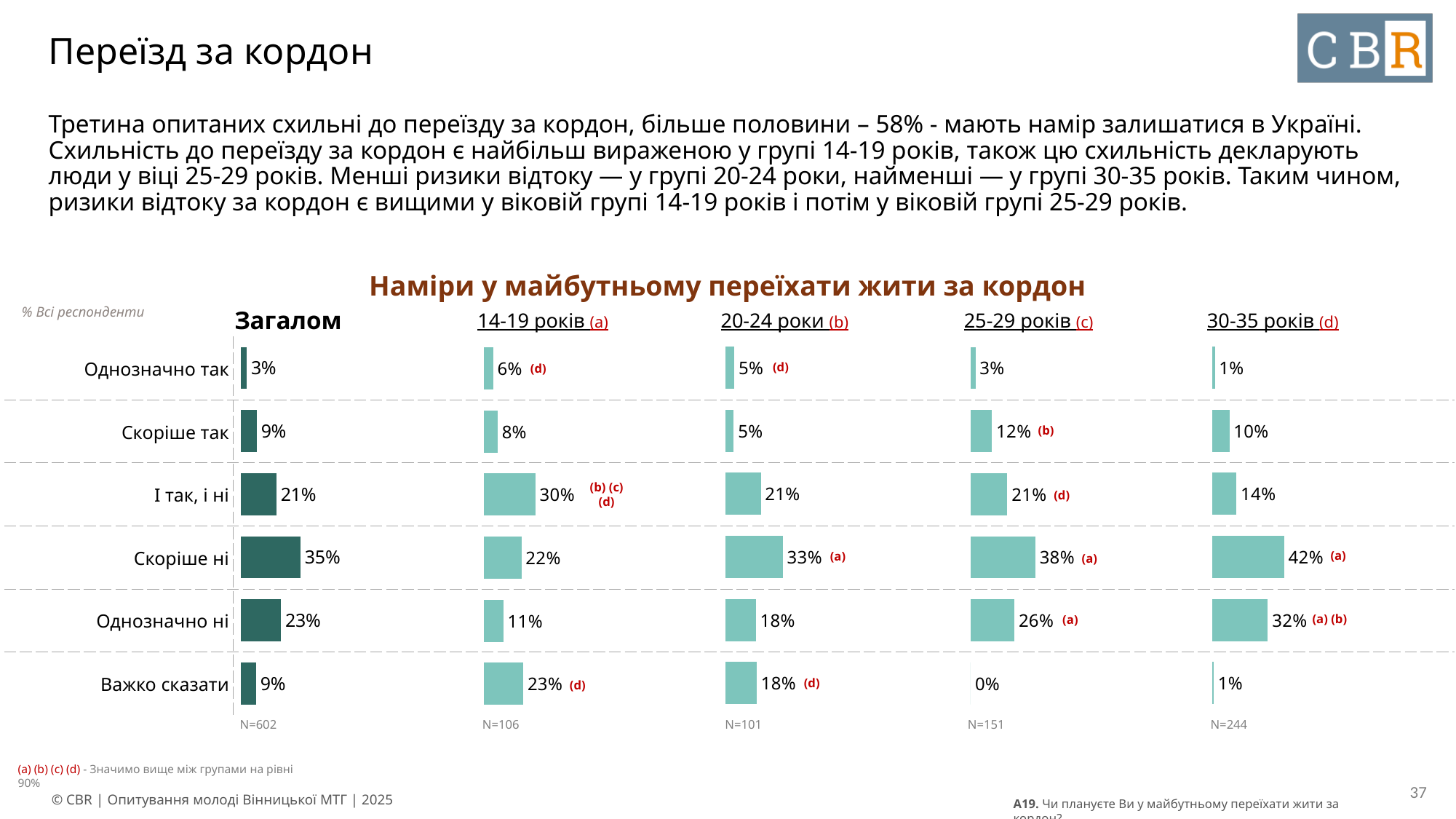
How many age-group columns (excluding "Загалом") are shown in the chart? 4 In the "Загалом" column, what is the value for "Скоріше ні"? 35% Which is larger: "Однозначно так" in the "14-19 років" column or "Однозначно так" in the "30-35 років" column? 14-19 років What is the difference between "Скоріше ні" in the "30-35 років" column and "Скоріше ні" in the "14-19 років" column? 20% How many response categories are shown in the chart? 6 In the "14-19 років" column, what is the value for "І так, і ні"? 30% What is the title of the chart? Наміри у майбутньому переїхати жити за кордон In the "25-29 років" column, what is the value for "Важко сказати"? 0% What type of chart is shown on the slide? Bar chart In the "Загалом" column, which category has the lowest value? Однозначно так In the "20-24 роки" column, which category has the highest value? Скоріше ні In the "30-35 років" column, what is the value for "Однозначно ні"? 32%